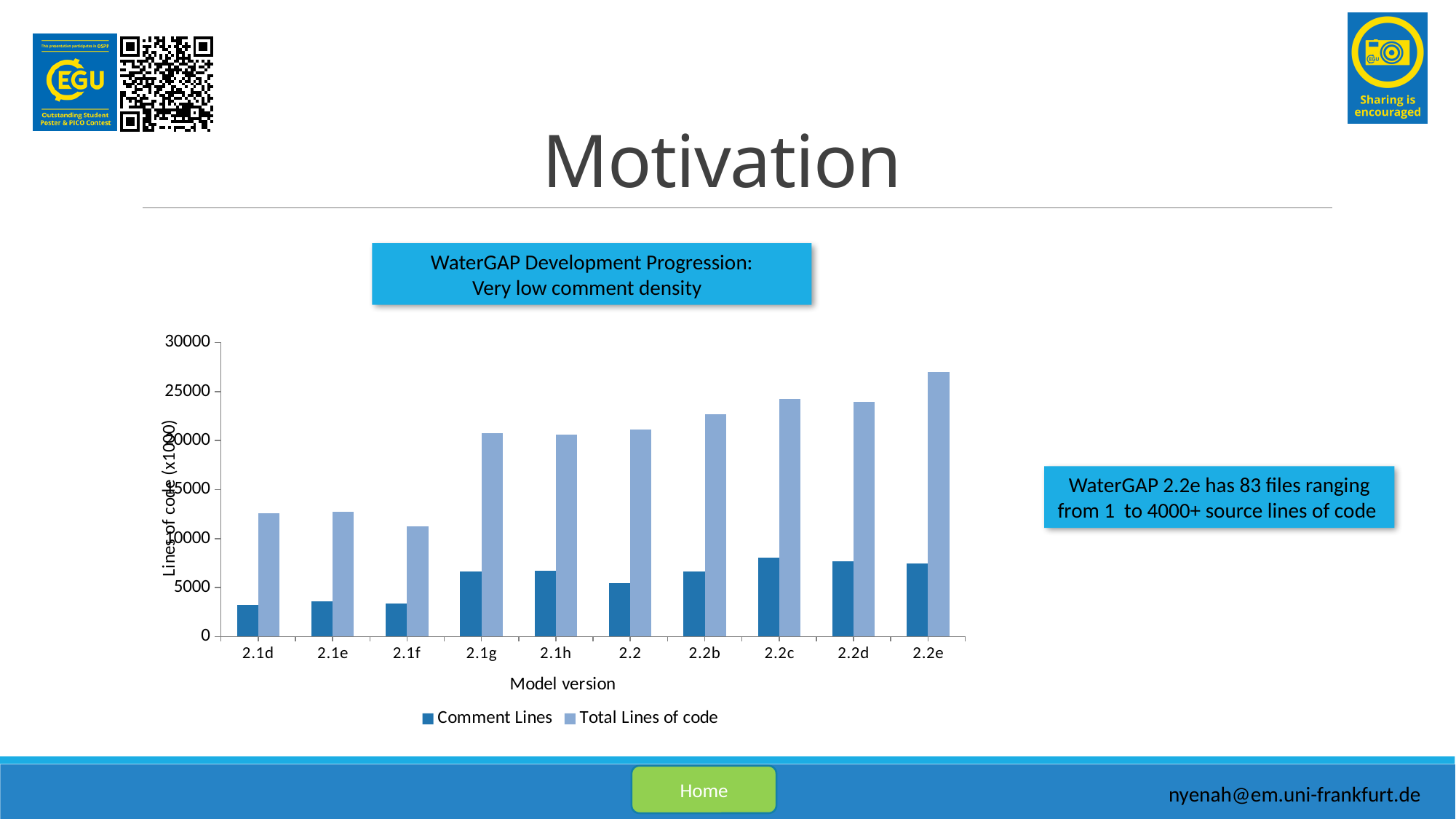
What kind of chart is shown on the slide? bar chart Is the Comment Lines value for 2.1d greater or less than 5000? less What is the title of the chart's x axis? Model version Which model version has the lowest Total Lines of code? 2.1f How many series does the chart's legend list? 2 Is the Comment Lines value for 2.2c greater or less than 5000? greater Do the Total Lines of code values generally rise or fall from 2.1d to 2.2e? rise How many model versions are shown on the x axis of the chart? 10 Which has a larger Total Lines of code value, 2.1d or 2.1g? 2.1g Is the Total Lines of code value for 2.1f greater or less than 15000? less Which model version has the highest Total Lines of code? 2.2e